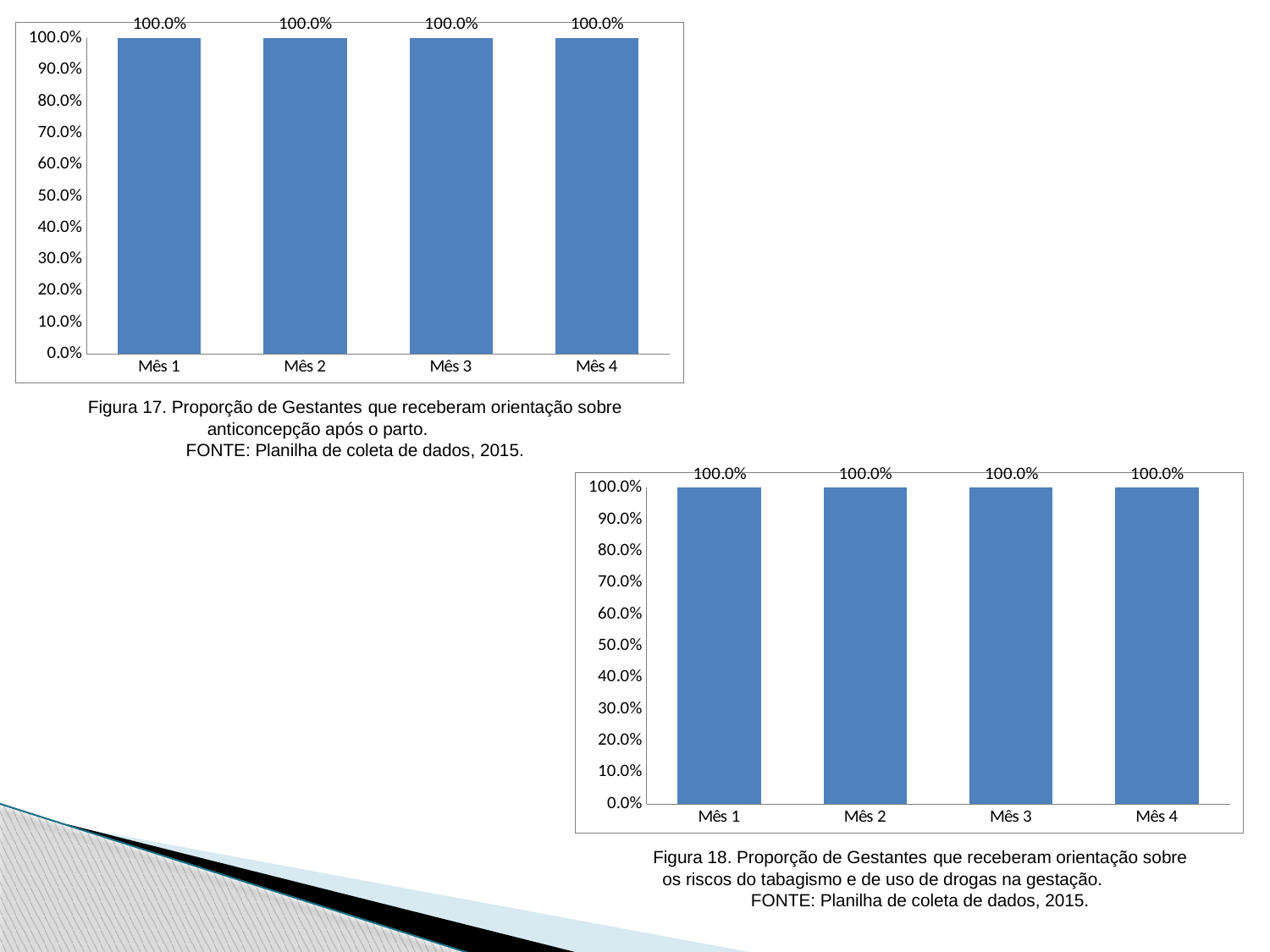
In the bottom-right chart (Figura 18), what is the difference between the values for Mês 4 and Mês 1? 0.0% In the bottom-right chart (Figura 18), what is the value for Mês 2? 100.0% In the top-left chart (Figura 17), what is the value for Mês 4? 100.0% How many charts are shown on the slide? 2 In the top-left chart (Figura 17), what is the value for Mês 1? 100.0% What kind of chart is the top-left chart (Figura 17)? Bar chart How many bars are shown in the bottom-right chart (Figura 18)? 4 How many categories are shown in the top-left chart (Figura 17)? 4 In the bottom-right chart (Figura 18), what is the value for Mês 3? 100.0% In the bottom-right chart (Figura 18), do the values rise, fall, or stay the same from Mês 1 to Mês 4? Stay the same In the top-left chart (Figura 17), what is the difference between the values for Mês 1 and Mês 3? 0.0% In the top-left chart (Figura 17), is the value for Mês 2 greater or less than 50.0%? greater